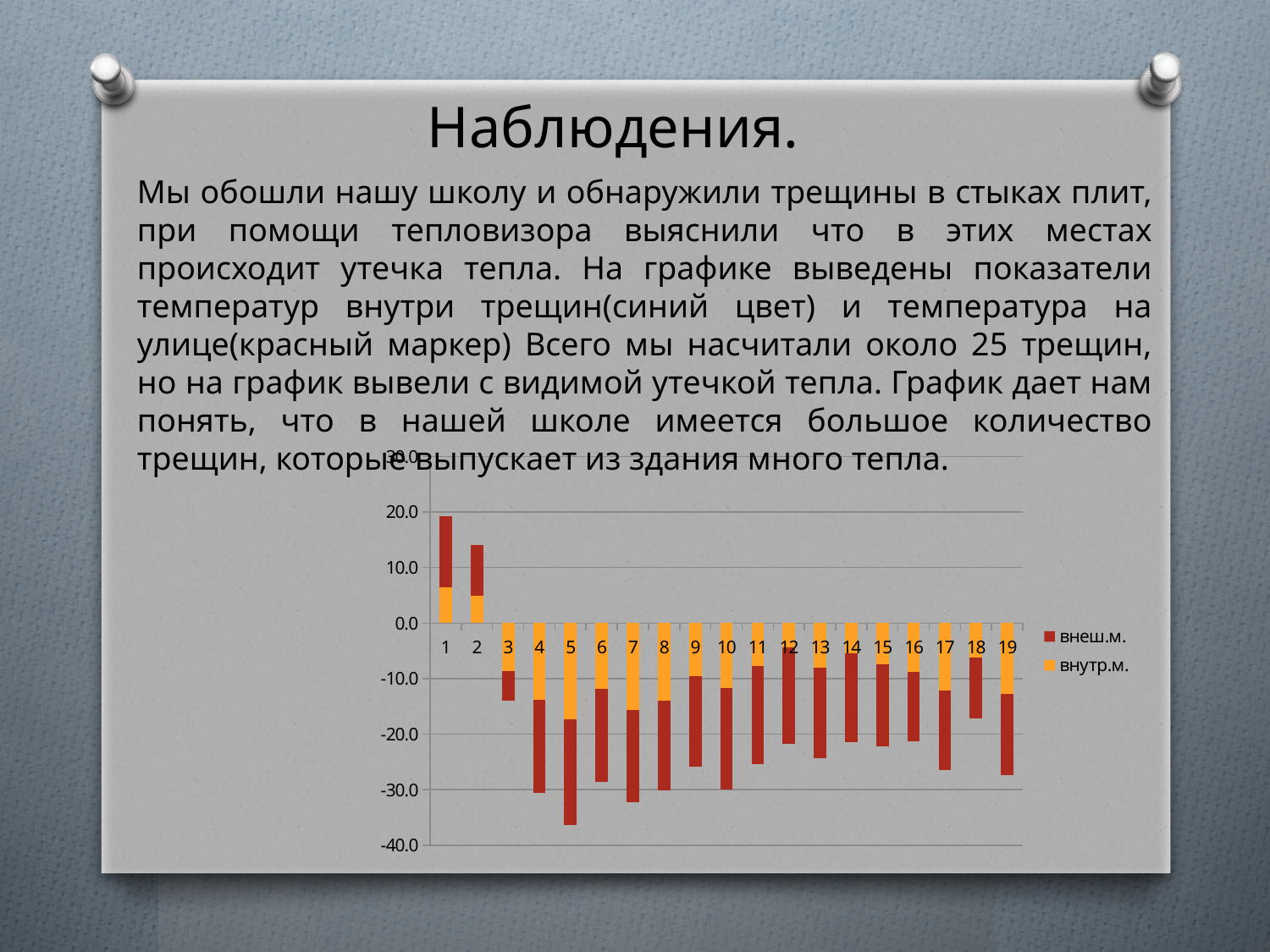
Is the stacked total for category 5 greater or less than -30.0? less Which has the higher stacked total, category 1 or category 2? Category 1 What are the two series named in the chart legend? внеш.м. and внутр.м. Which category has the highest stacked total in the chart? 1 Is the stacked total for category 3 greater or less than -20.0? greater What kind of chart is shown on the slide? Stacked bar chart How many series does the chart legend list? 2 How many categories in the chart have positive (above zero) values? 2 How many categories are shown along the x axis of the chart? 19 Is the stacked total for category 1 greater or less than 10.0? greater Which category has the lowest (most negative) stacked total in the chart? 5 Which colour represents the series внеш.м. in the chart? Dark red